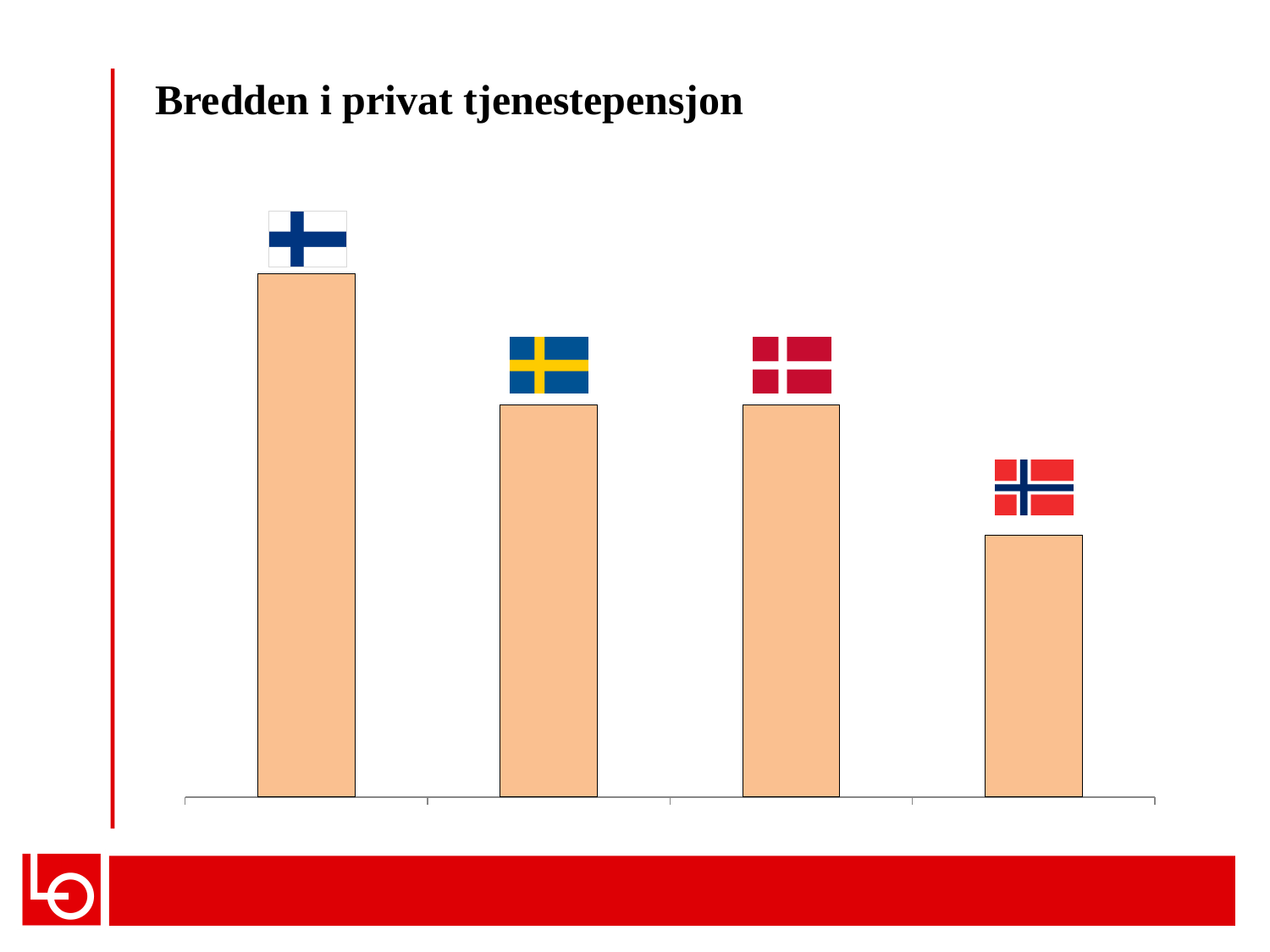
Which country, identified by its flag, has the highest bar? Finland Which bar is taller, the one with the Swedish flag or the one with the Norwegian flag? Sweden Do the bar heights generally rise or fall from left to right across the chart? fall Which bar is taller, the one with the Finnish flag or the one with the Norwegian flag? Finland Which country's flag is placed above the first bar from the left? Finland Which country, identified by its flag, has the lowest bar? Norway How many bars does the chart show? 4 Which bar is taller, the one with the Finnish flag or the one with the Danish flag? Finland What is the title of the chart on the slide? Bredden i privat tjenestepensjon What kind of chart is shown on the slide? bar chart